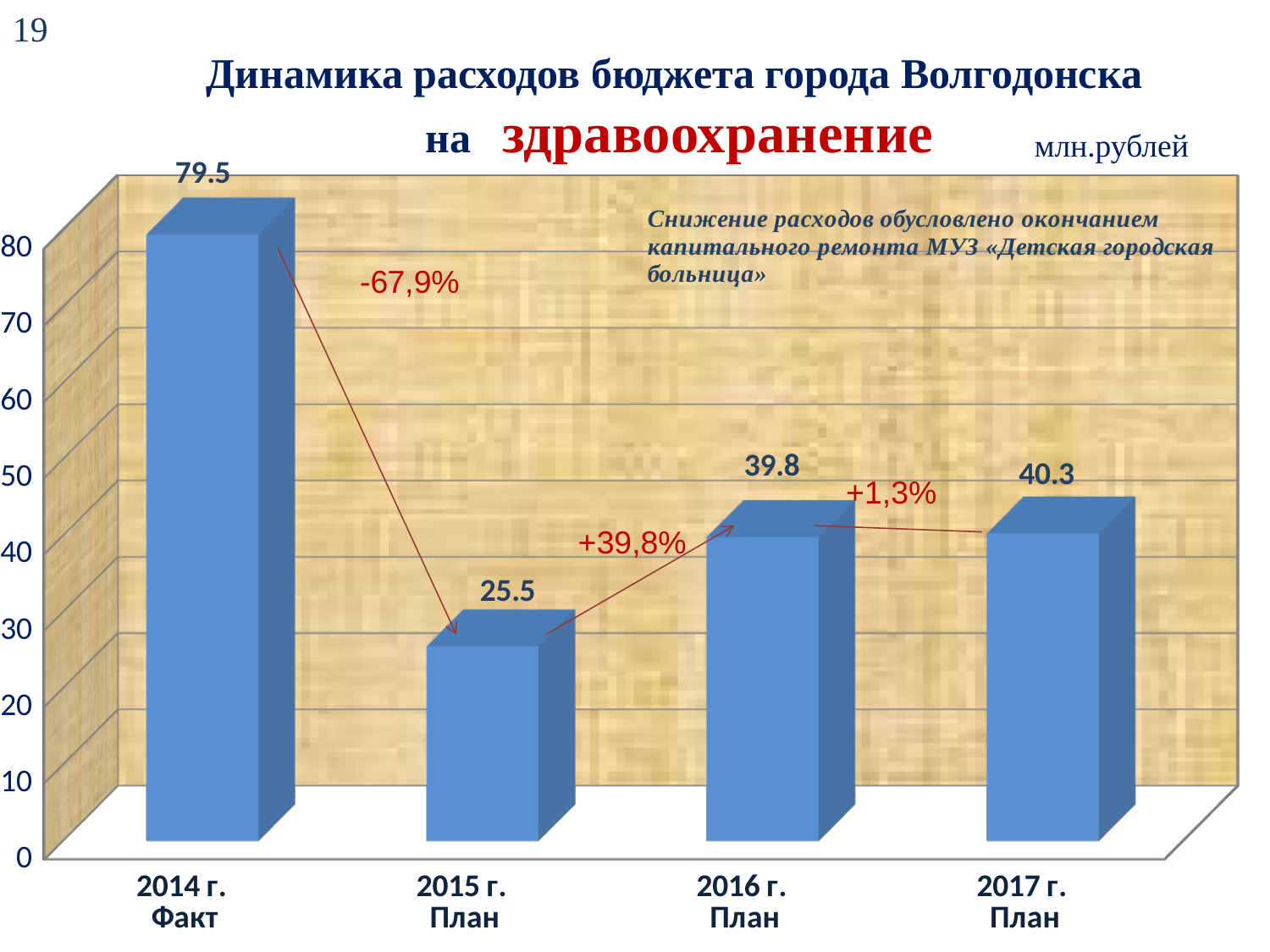
What is the value for 2016 г. План? 39.8 Which is larger, the value for 2016 г. План or 2015 г. План? 2016 г. План What is the difference between the values for 2016 г. План and 2015 г. План? 14.3 What is the value for 2017 г. План? 40.3 What percentage change is annotated between 2014 г. Факт and 2015 г. План? -67,9% What kind of chart is shown on the slide? bar chart Which category has the highest value? 2014 г. Факт What is the difference between the values for 2014 г. Факт and 2015 г. План? 54.0 How many categories are shown on the x axis? 4 What is the value for 2015 г. План? 25.5 Which category has the lowest value? 2015 г. План What is the value for 2014 г. Факт? 79.5